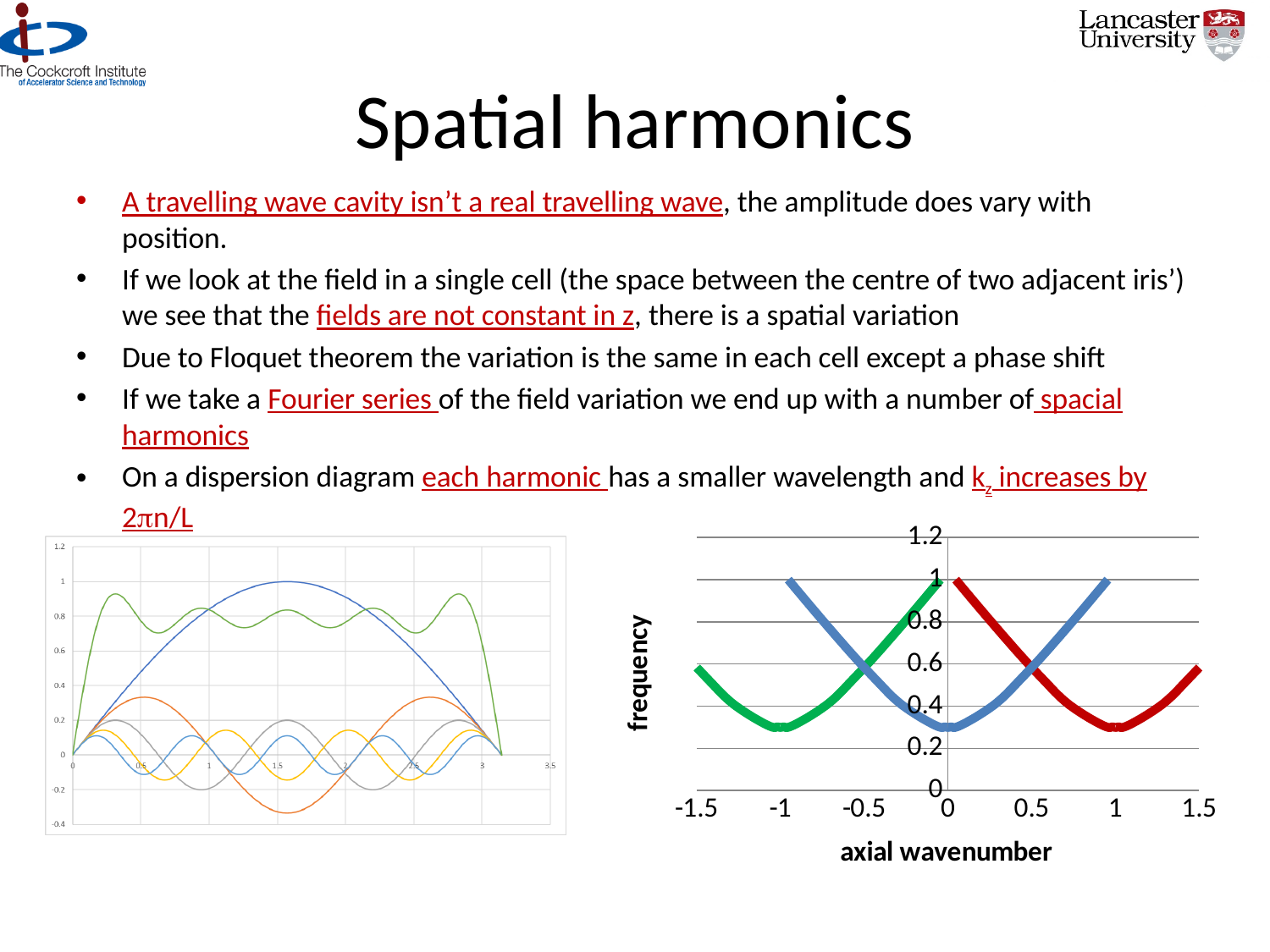
What kind of chart is the chart on the left of the slide? line chart On the chart on the right of the slide, at what axial wavenumber does the red curve reach its minimum? 1 On the chart on the right of the slide, at what axial wavenumber does the blue curve reach its minimum? 0 On the chart on the right of the slide, is the frequency of the blue curve at axial wavenumber 1 greater or less than 0.8? greater On the chart on the right of the slide, is the minimum frequency of the blue curve greater or less than 0.4? less What is the x-axis title of the chart on the right of the slide? axial wavenumber On the chart on the right of the slide, does the red curve rise or fall as the axial wavenumber goes from 0 to 1? fall What is the y-axis title of the chart on the right of the slide? frequency What kind of chart is the chart on the right of the slide? line chart How many curves are plotted on the chart on the right of the slide? 3 What is the highest tick value on the y axis of the chart on the right of the slide? 1.2 On the chart on the right of the slide, at what axial wavenumber does the green curve reach its minimum? -1